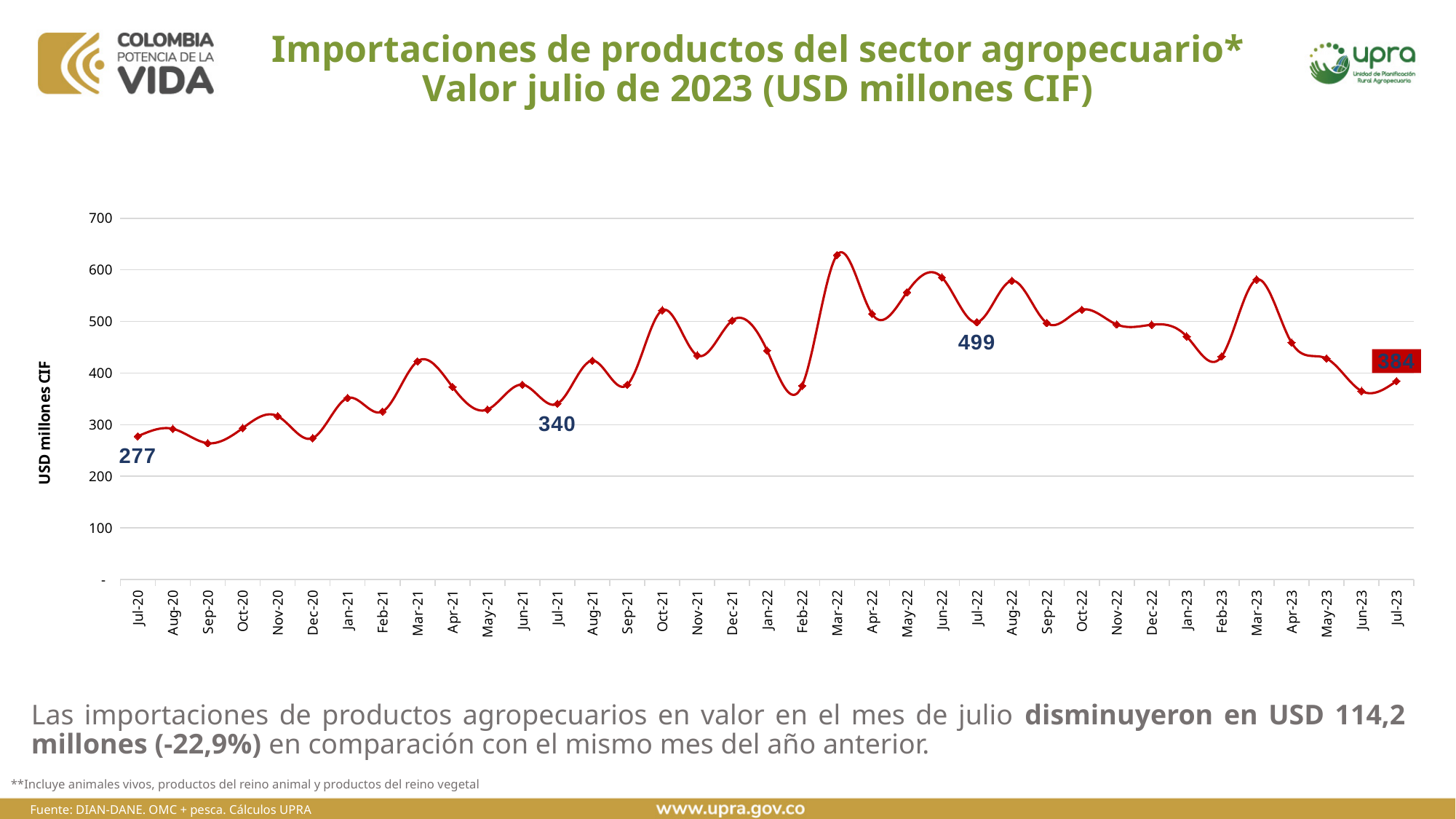
Is the value for Feb-22 greater or less than 400? less How many monthly data points are plotted on the chart? 37 Which month has the highest value on the chart? Mar-22 What is the difference between the values for Jul-22 and Jul-23? 115 What is the value for Jul-23? 384 Is the value for Mar-22 greater or less than 600? greater Which is larger, the value for Jul-22 or the value for Jul-21? Jul-22 What kind of chart is shown on the slide? line chart What is the difference between the values for Jul-21 and Jul-20? 63 What is the value for Jul-22? 499 What is the value for Jul-20? 277 What is the value for Jul-21? 340